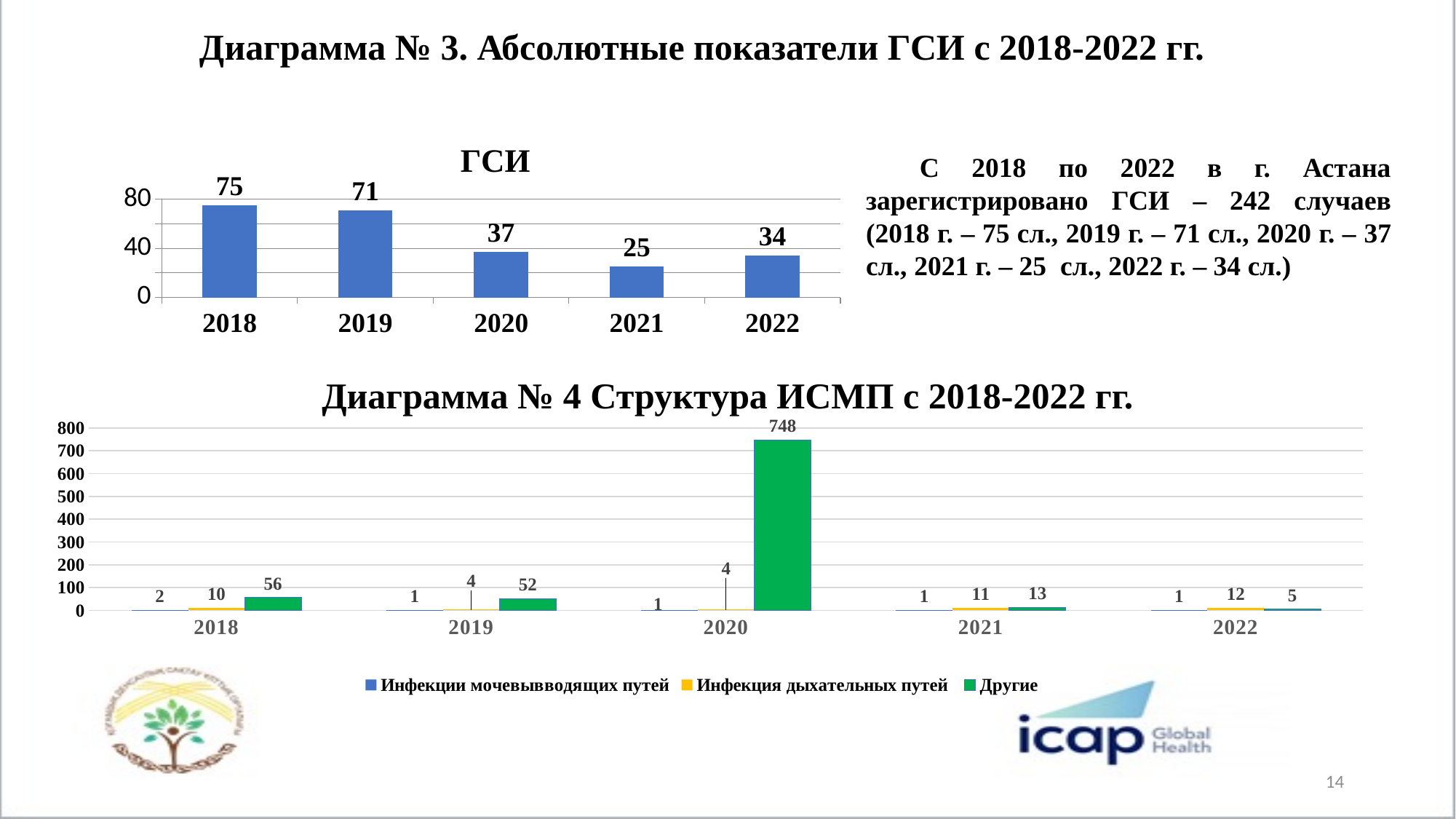
In the top chart titled ГСИ, what is the difference between the values for 2018 and 2022? 41 In the top chart titled ГСИ, what kind of chart is it? bar chart In the top chart titled ГСИ, which year has the lowest value? 2021 In the bottom chart (Диаграмма № 4), how many series does the legend list? 3 In the bottom chart (Диаграмма № 4), what is the value of Другие for 2020? 748 In the top chart titled ГСИ, what is the value for 2018? 75 In the bottom chart (Диаграмма № 4), what is the difference between Другие for 2018 and Другие for 2019? 4 In the bottom chart (Диаграмма № 4), what is the value of Инфекция дыхательных путей for 2022? 12 In the top chart titled ГСИ, is the value for 2020 greater or less than 40? less In the bottom chart (Диаграмма № 4), which colour represents Другие in the legend? green In the top chart titled ГСИ, how many years are shown on the x axis? 5 In the bottom chart (Диаграмма № 4), which is larger for 2021: Инфекция дыхательных путей or Другие? Другие